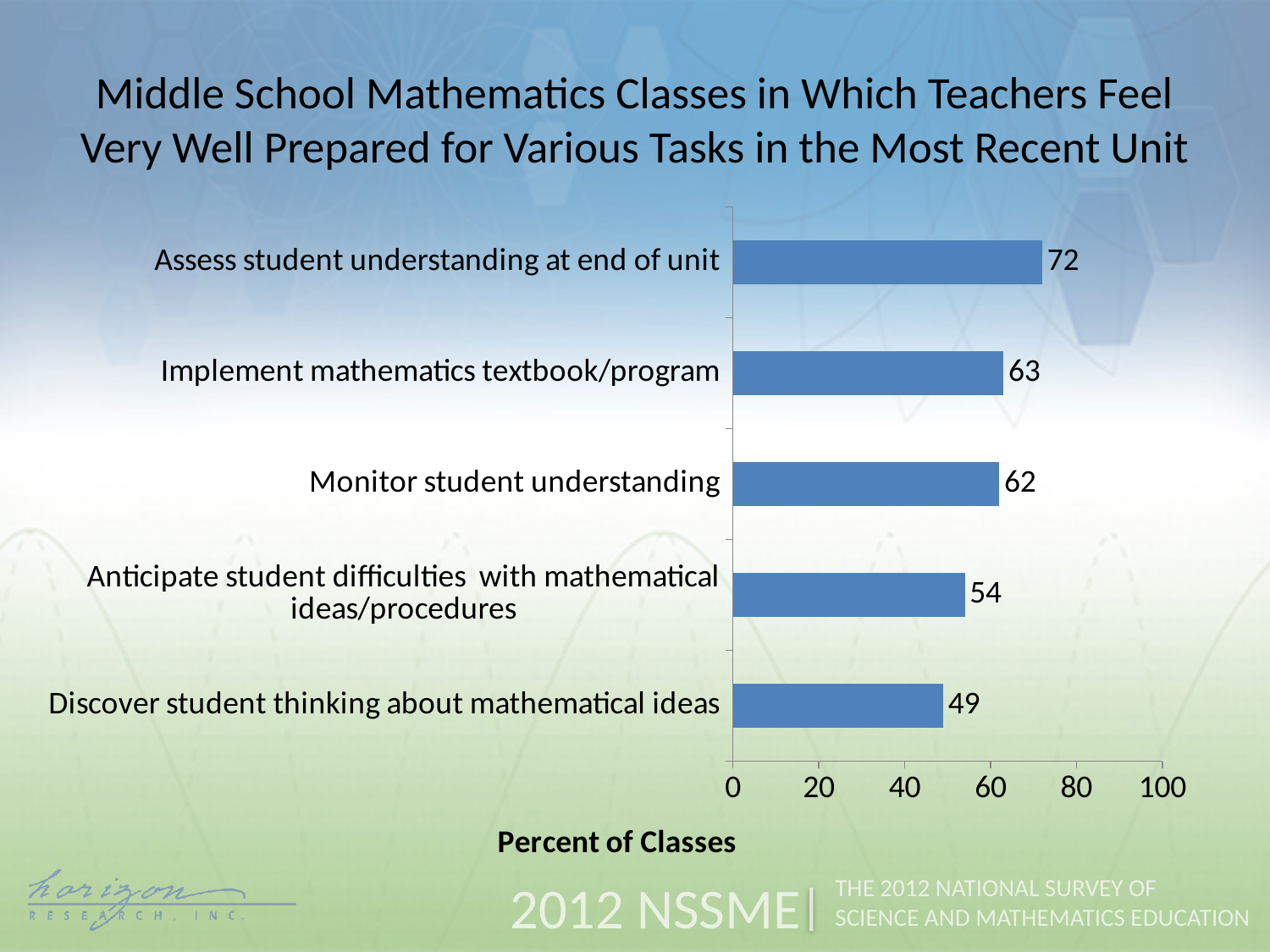
What percent of classes is shown for "Assess student understanding at end of unit"? 72 What is the value for "Anticipate student difficulties with mathematical ideas/procedures"? 54 What is the difference between the values for "Implement mathematics textbook/program" and "Anticipate student difficulties with mathematical ideas/procedures"? 9 What is the label on the horizontal axis of the chart? Percent of Classes Which task has the lowest percent of classes? Discover student thinking about mathematical ideas Which task has the highest percent of classes? Assess student understanding at end of unit Is the value for "Discover student thinking about mathematical ideas" greater or less than 60? less What kind of chart is shown on the slide? bar chart How many tasks are shown in the chart? 5 What is the value for "Discover student thinking about mathematical ideas"? 49 Which is larger, the value for "Implement mathematics textbook/program" or the value for "Monitor student understanding"? Implement mathematics textbook/program What is the difference between the values for "Assess student understanding at end of unit" and "Discover student thinking about mathematical ideas"? 23